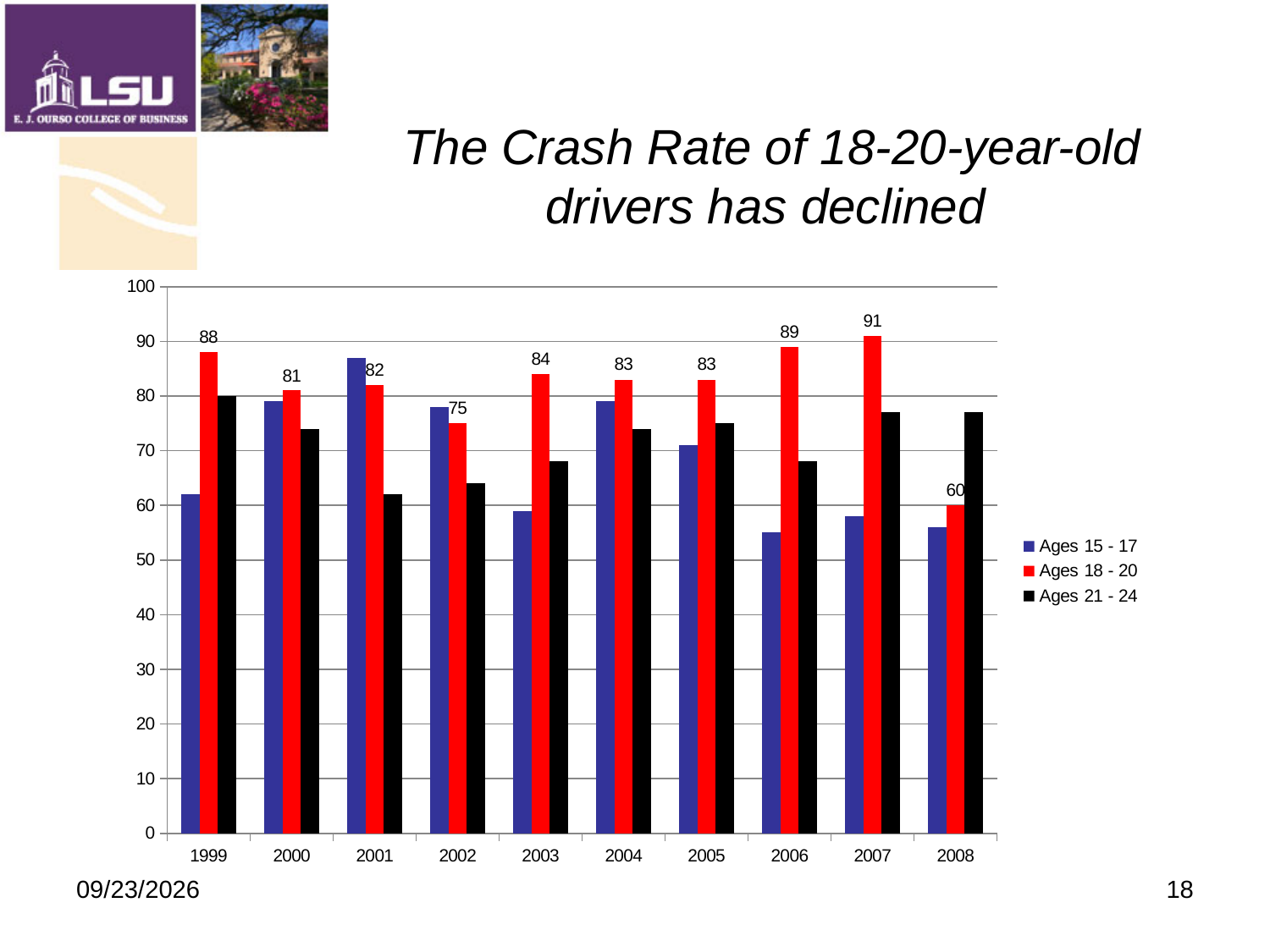
What is the value for Ages 18 - 20 in 2007? 91 In which year is the value for Ages 18 - 20 lowest? 2008 What kind of chart is shown on the slide? bar chart What is the difference between the Ages 18 - 20 values for 2007 and 2008? 31 In which year is the value for Ages 18 - 20 highest? 2007 What is the value for Ages 18 - 20 in 1999? 88 How many years are shown on the x axis? 10 What is the value for Ages 18 - 20 in 2008? 60 Is the value for Ages 15 - 17 in 2006 greater or less than 60? less Is the value for Ages 21 - 24 in 1999 greater or less than 70? greater How many series does the legend list? 3 Which year has the larger value for Ages 18 - 20, 2005 or 2006? 2006